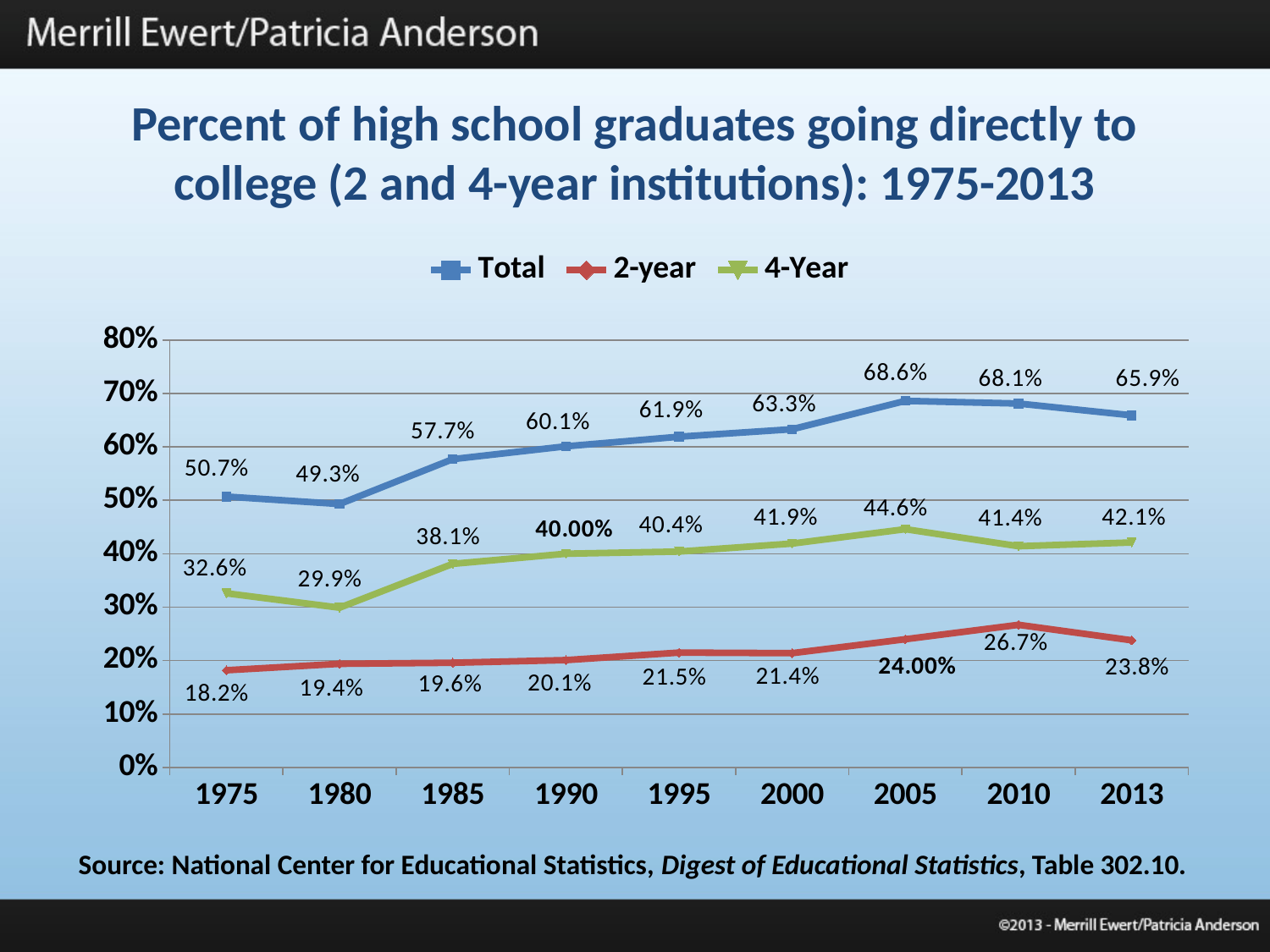
How many years are shown on the x axis? 9 How many series does the legend list? 3 Does the Total series rise or fall from 1980 to 2005? rise In which year is the Total series highest? 2005 What is the 4-Year value for 2013? 42.1% Is the 4-Year value for 1985 greater or less than 30%? greater What kind of chart is shown? line chart What is the Total value for 2005? 68.6% What is the difference between the Total value in 2013 and the Total value in 1975? 15.2% Which is larger, the 2-year value in 2010 or the 2-year value in 2013? 2010 In which year is the 4-Year series lowest? 1980 What is the 2-year value for 1975? 18.2%